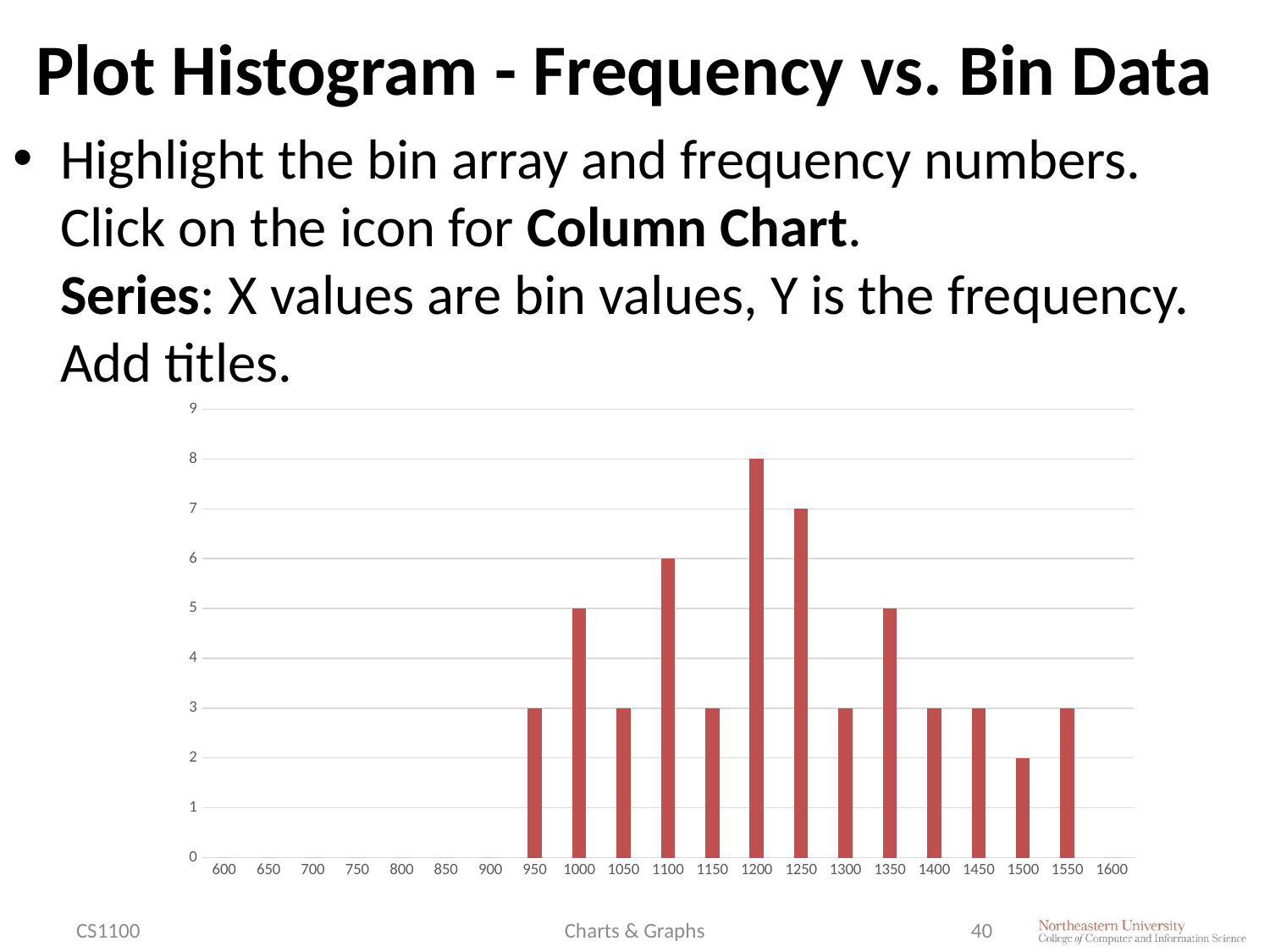
Is the frequency for the 1350 bin greater or less than 4? greater Among the bins that have a bar, which has the lowest frequency? 1500 What is the frequency for the 1200 bin? 8 Do the frequencies rise or fall from the 1200 bin to the 1300 bin? fall What is the difference between the frequencies of the 1200 bin and the 1250 bin? 1 Which bin has a higher frequency, 1000 or 1100? 1100 What kind of chart is shown on the slide? bar chart What is the frequency for the 1500 bin? 2 Which bin has the highest frequency? 1200 What is the frequency for the 1250 bin? 7 What is the frequency for the 1100 bin? 6 How many bin labels are shown on the x axis? 21